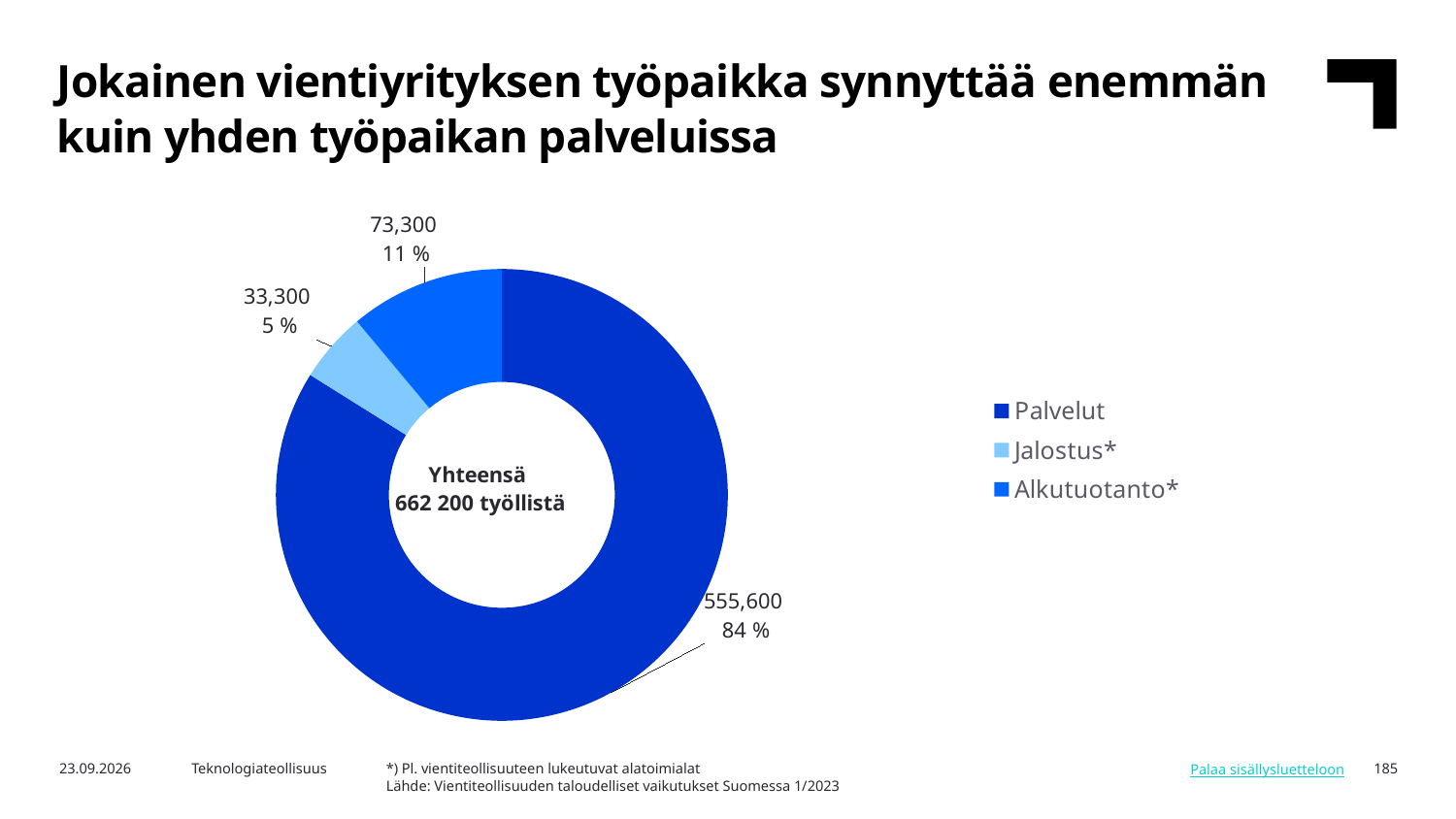
What kind of chart is shown on the slide? Pie chart (doughnut) What is the value for Jalostus*? 33,300 What is the difference between the values for Alkutuotanto* and Jalostus*? 40,000 What total is shown in the centre of the chart? 662 200 työllistä What share of the pie does Palvelut represent? 84 % What is the value for Palvelut? 555,600 Which category has the smallest slice? Jalostus* What is the value for Alkutuotanto*? 73,300 How many slices does the chart have? 3 What share of the pie does Alkutuotanto* represent? 11 % How many entries does the legend list? 3 Which category has the largest slice? Palvelut